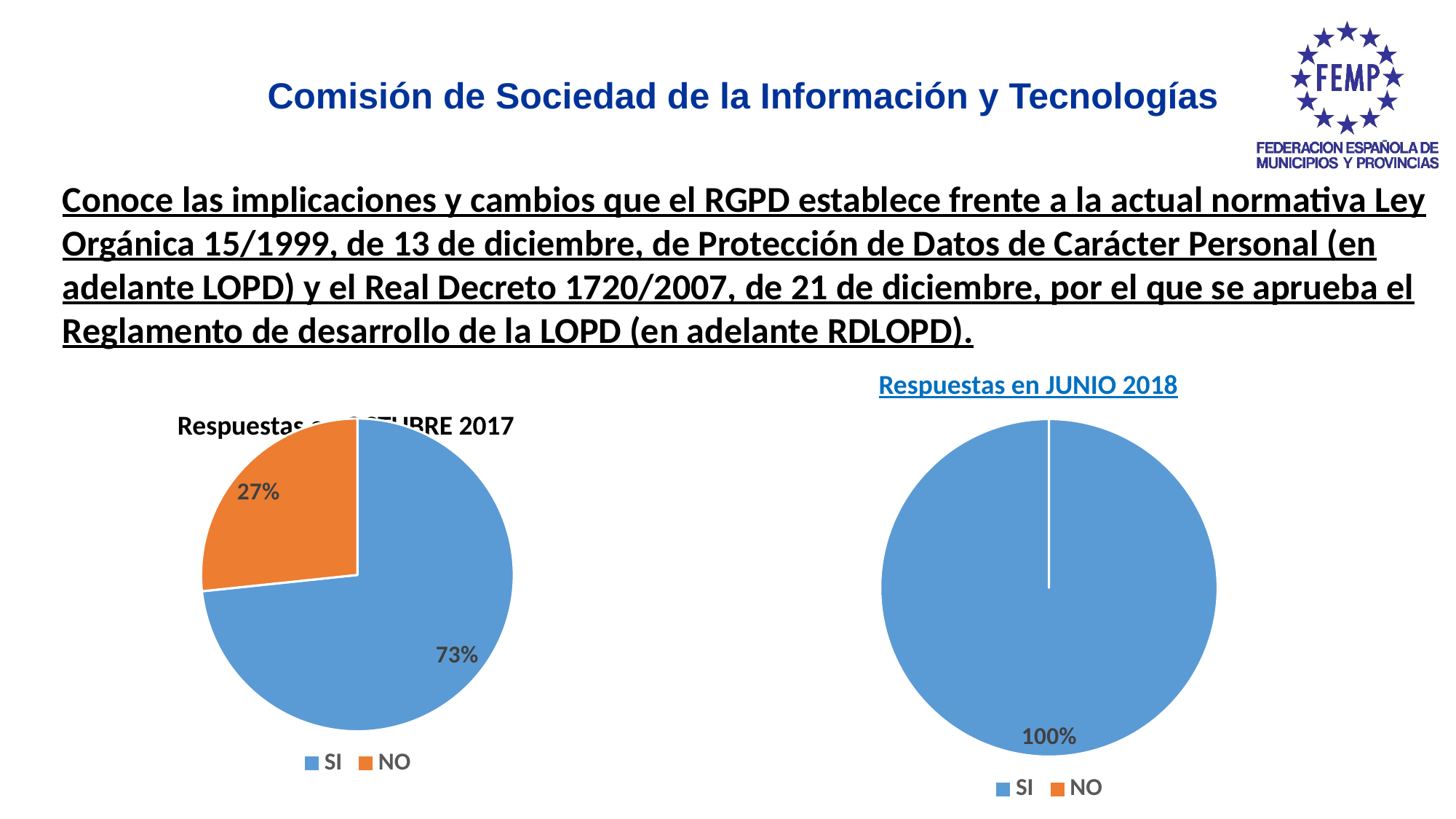
In the left pie chart (Respuestas en OCTUBRE 2017), which is larger, SI or NO? SI In the left pie chart (Respuestas en OCTUBRE 2017), what percentage of responses were SI? 73% In the left pie chart (Respuestas en OCTUBRE 2017), what is the difference in percentage points between SI and NO? 46 In the left pie chart (Respuestas en OCTUBRE 2017), what percentage of responses were NO? 27% How many entries does the legend of the left pie chart (Respuestas en OCTUBRE 2017) list? 2 How many charts are shown on the slide? 2 In the left pie chart (Respuestas en OCTUBRE 2017), which category has the largest share? SI What type of chart is used on the right side of the slide (Respuestas en JUNIO 2018)? Pie chart In the left pie chart (Respuestas en OCTUBRE 2017), which category has the smallest share? NO What is the title of the right pie chart? Respuestas en JUNIO 2018 In the right pie chart (Respuestas en JUNIO 2018), what percentage of responses were SI? 100% In the right pie chart (Respuestas en JUNIO 2018), what colour represents SI? Blue